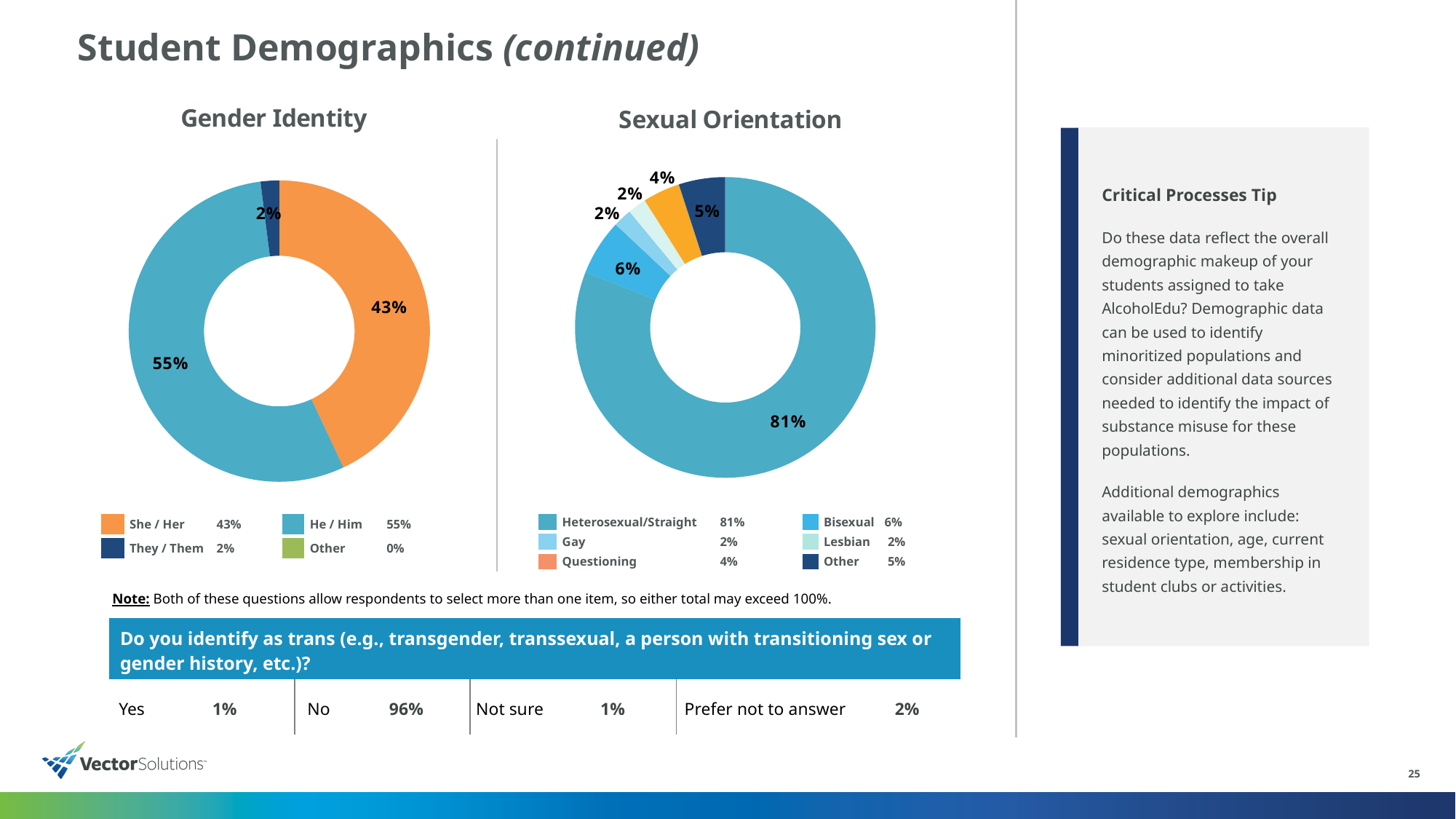
In the Gender Identity chart, what is the difference between the He / Him and She / Her percentages? 12% In the Sexual Orientation chart, what percentage is shown for Other? 5% What type of chart is used for Gender Identity? Pie chart (donut) In the Gender Identity chart, what percentage is shown for She / Her? 43% In the Gender Identity chart, what percentage is shown for They / Them? 2% In the Sexual Orientation chart, which is larger, Bisexual or Other? Bisexual How many categories does the Gender Identity legend list? 4 How many categories does the Sexual Orientation legend list? 6 In the Sexual Orientation chart, what percentage is shown for Bisexual? 6% In the Sexual Orientation chart, which category has the largest share? Heterosexual/Straight In the Sexual Orientation chart, what is the difference between the Bisexual and Lesbian percentages? 4% In the Gender Identity chart, which category has the largest share? He / Him